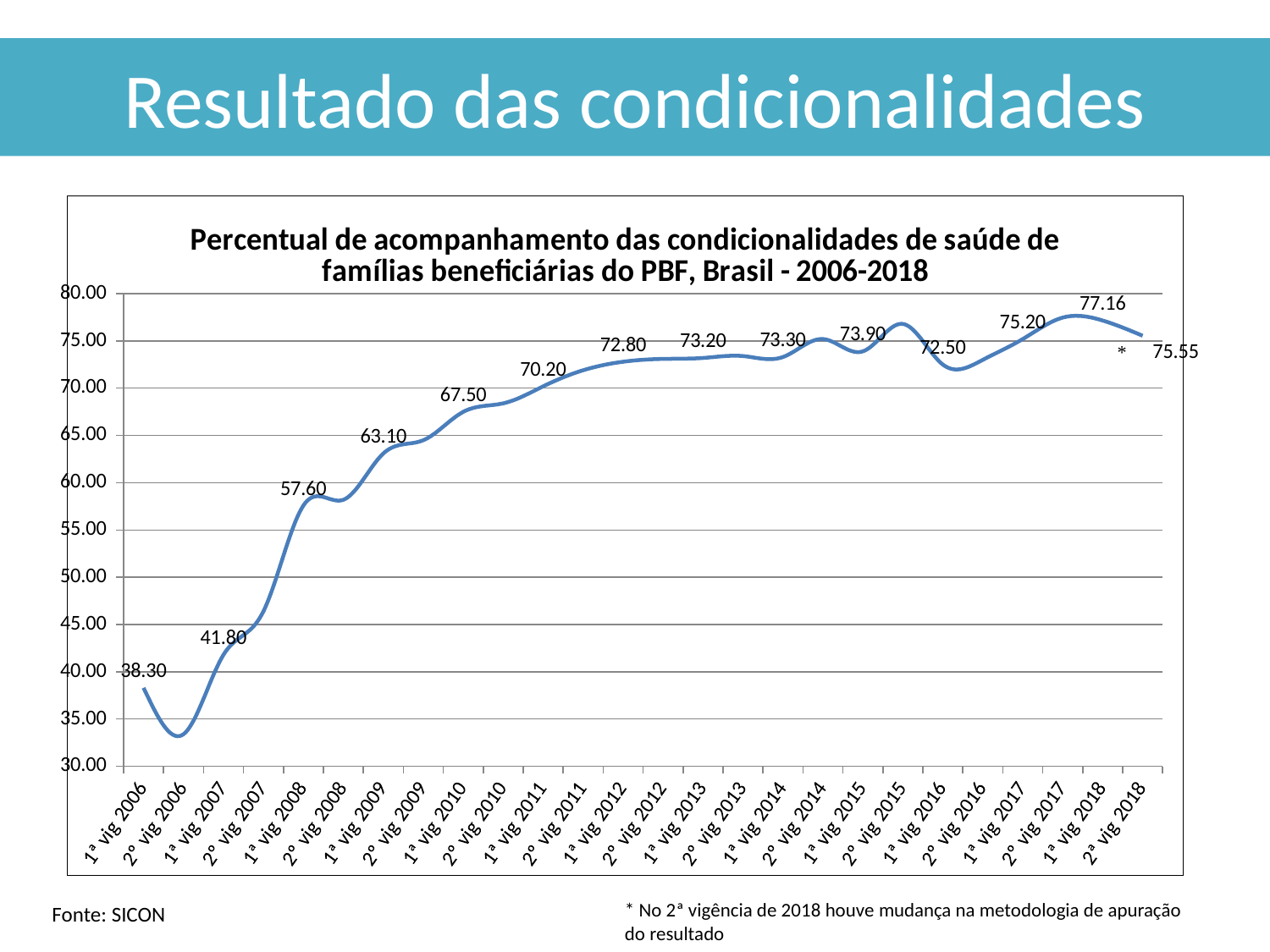
What is the value for 1ª vig 2008? 57.60 What is the value for 2ª vig 2018? 75.55 What is the difference between the values for 1ª vig 2018 and 2ª vig 2018? 1.61 Which period has the lowest value on the chart? 2° vig 2006 Which is larger, the value for 1ª vig 2016 or the value for 1ª vig 2017? 1ª vig 2017 Is the value for 2° vig 2006 greater or less than 35.00? less Overall, do the values rise or fall from 2006 to 2018? Rise What is the difference between the values for 1ª vig 2008 and 1ª vig 2007? 15.80 What type of chart is shown on the slide? Line chart What is the value for 1ª vig 2006? 38.30 What is the value for 1ª vig 2012? 72.80